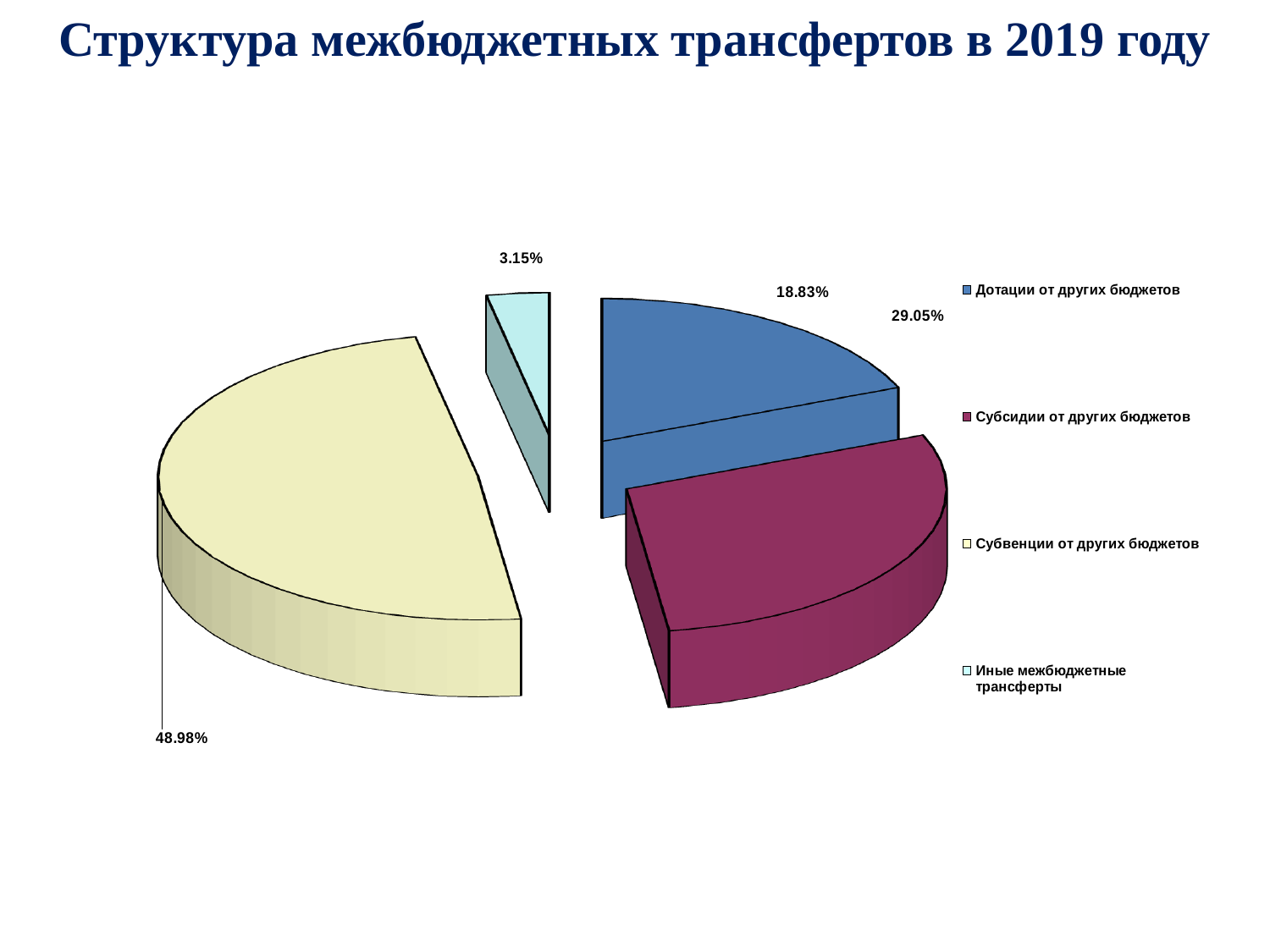
What share of the pie does Субсидии от других бюджетов have? 29.05% What is the difference between the shares of Субвенции от других бюджетов and Субсидии от других бюджетов? 19.93% What share of the pie does Субвенции от других бюджетов have? 48.98% What kind of chart is shown on the slide? Pie chart What share of the pie does Иные межбюджетные трансферты have? 3.15% What is the title of the slide? Структура межбюджетных трансфертов в 2019 году Which category has the smallest share of the pie? Иные межбюджетные трансферты Which category has the largest share of the pie? Субвенции от других бюджетов What share of the pie does Дотации от других бюджетов have? 18.83% How many categories does the pie chart show? 4 What is the difference between the shares of Дотации от других бюджетов and Иные межбюджетные трансферты? 15.68% Which is larger: the share of Субсидии от других бюджетов or the share of Дотации от других бюджетов? Субсидии от других бюджетов